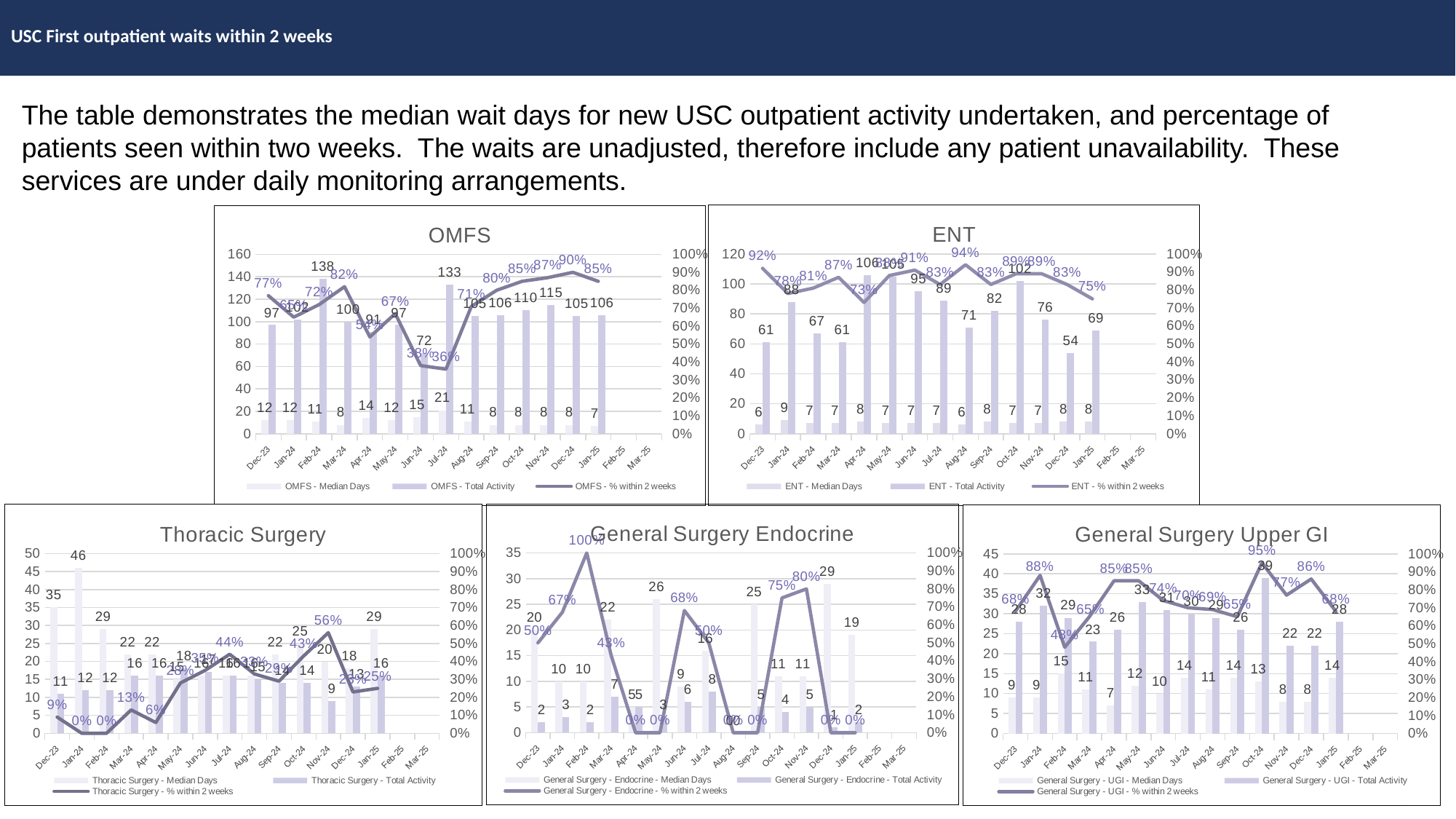
In the OMFS chart, what is the difference between the Total Activity for Feb-24 and Jan-24? 36 In the OMFS chart, what is the % within 2 weeks for Dec-24? 90% In the General Surgery Upper GI chart, which month has the highest Total Activity? Oct-24 In the Thoracic Surgery chart, what is the % within 2 weeks for Nov-24? 56% How many charts are shown on the slide? 5 In the OMFS chart, which month has the highest Total Activity? Feb-24 In the General Surgery Endocrine chart, what is the % within 2 weeks for Feb-24? 100% In the Thoracic Surgery chart, what is the Median Days value for Jan-24? 46 In the ENT chart, which is larger, the Total Activity for Jan-24 or for Feb-24? Jan-24 In the ENT chart, which month has the lowest Total Activity? Dec-24 How many series does the legend of the ENT chart list? 3 In the OMFS chart, what is the Total Activity value for Feb-24? 138